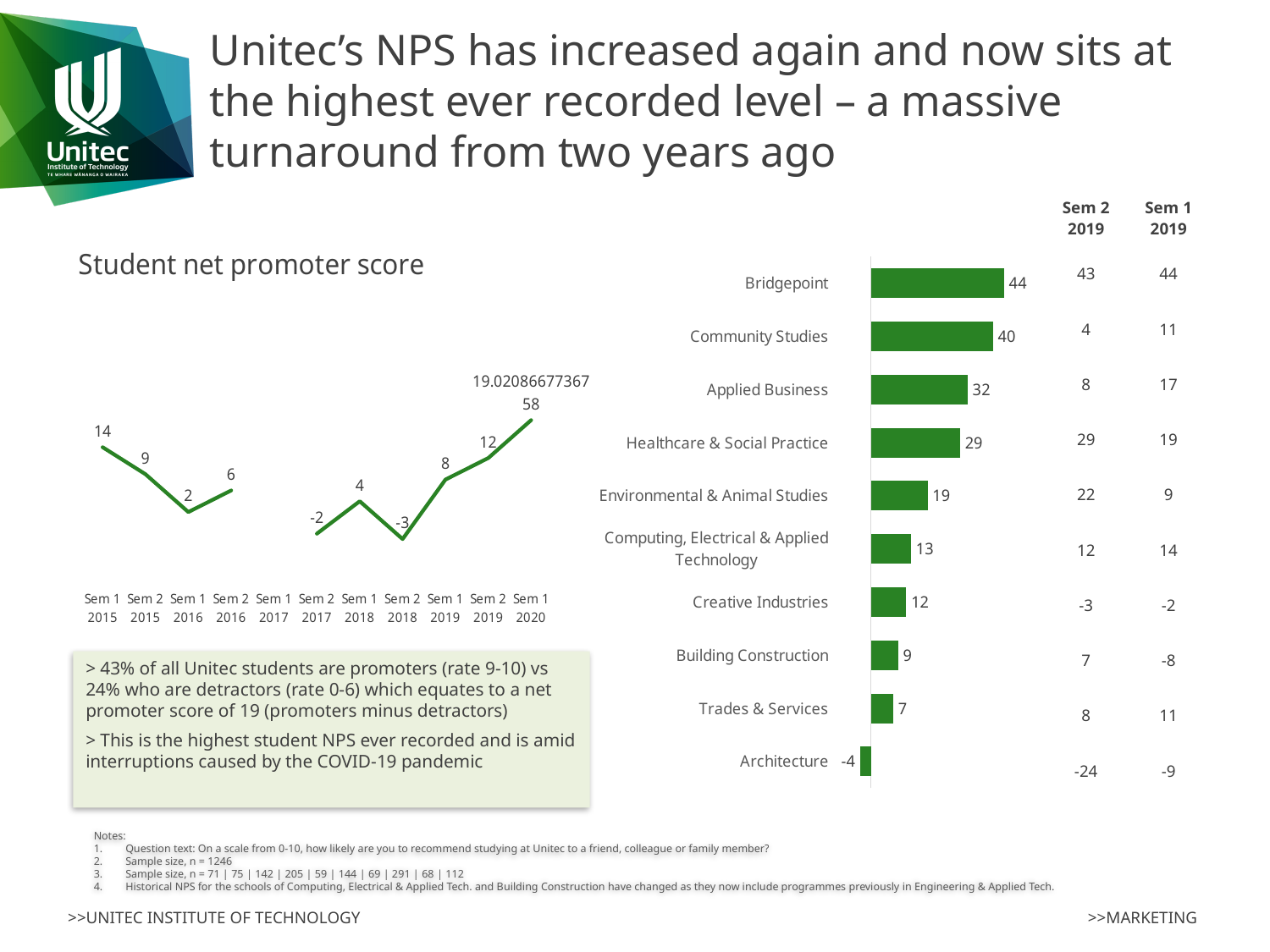
In the 'Student net promoter score' chart, what is the value for Sem 1 2015? 14 In the 'Student net promoter score' chart, what is the difference between the values for Sem 1 2019 and Sem 2 2018? 11 What kind of chart is the chart on the right of the slide? Bar chart In the 'Student net promoter score' chart, what is the value for Sem 2 2018? -3 In the bar chart on the right, what is the value for Community Studies? 40 In the bar chart on the right, which school has the highest value? Bridgepoint In the bar chart on the right, which school has the lowest value? Architecture In the 'Student net promoter score' chart, which semester has the lowest value? Sem 2 2018 How many schools are shown in the bar chart on the right? 10 What kind of chart is the 'Student net promoter score' chart? Line chart In the bar chart on the right, what is the difference between the values for Bridgepoint and Applied Business? 12